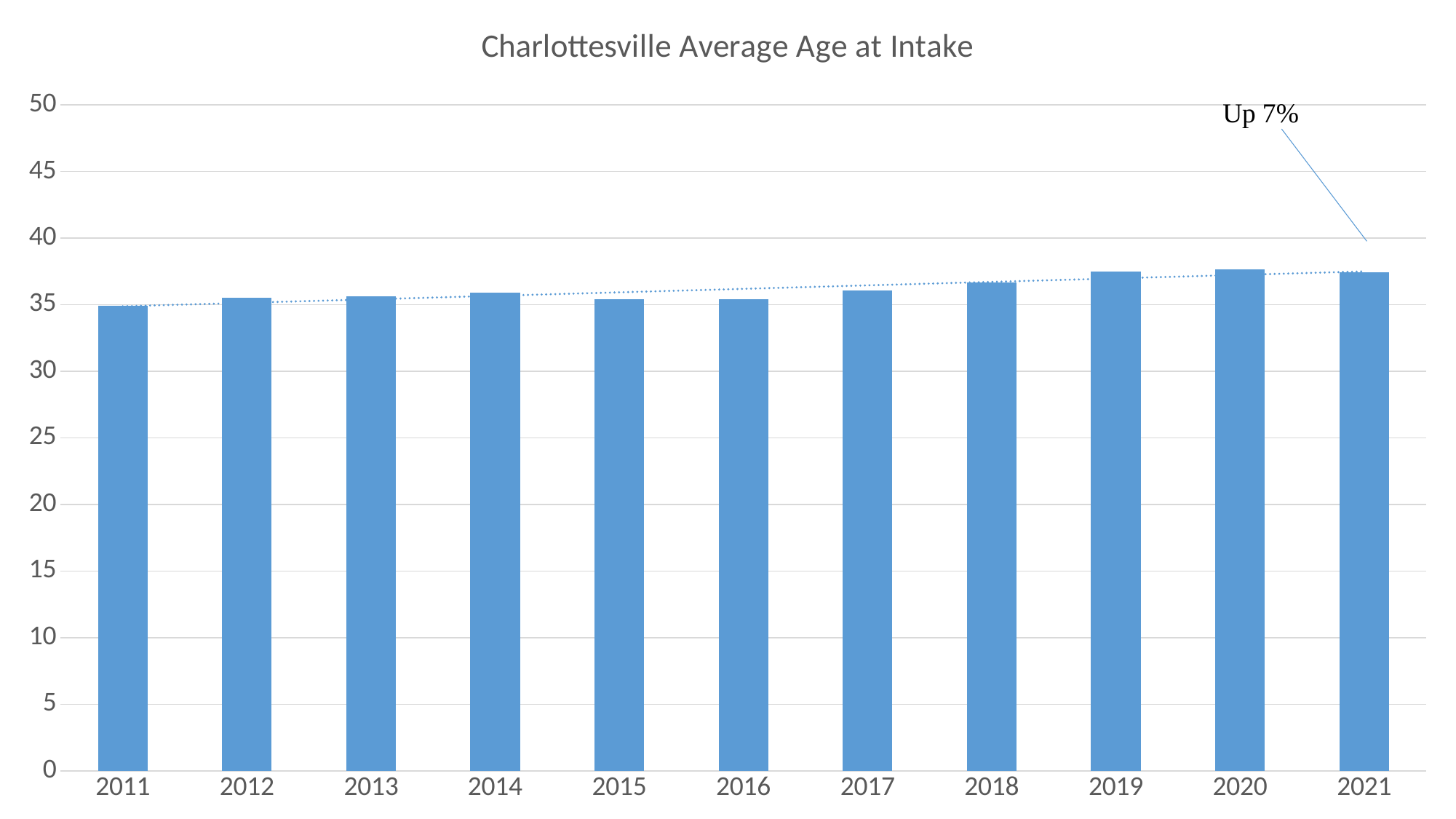
Is the value for 2011 greater or less than 40? less What is the title of the chart? Charlottesville Average Age at Intake What kind of chart is shown on the slide? bar chart Is the value for 2020 greater or less than 35? greater Do the values generally rise or fall from 2011 to 2021? rise Which is larger, the value for 2011 or the value for 2020? 2020 Which is larger, the value for 2012 or the value for 2018? 2018 How many years are shown on the x axis of the chart? 11 Is the value for 2021 greater or less than 40? less What does the annotation at the top right of the chart say? Up 7% Which is larger, the value for 2014 or the value for 2019? 2019